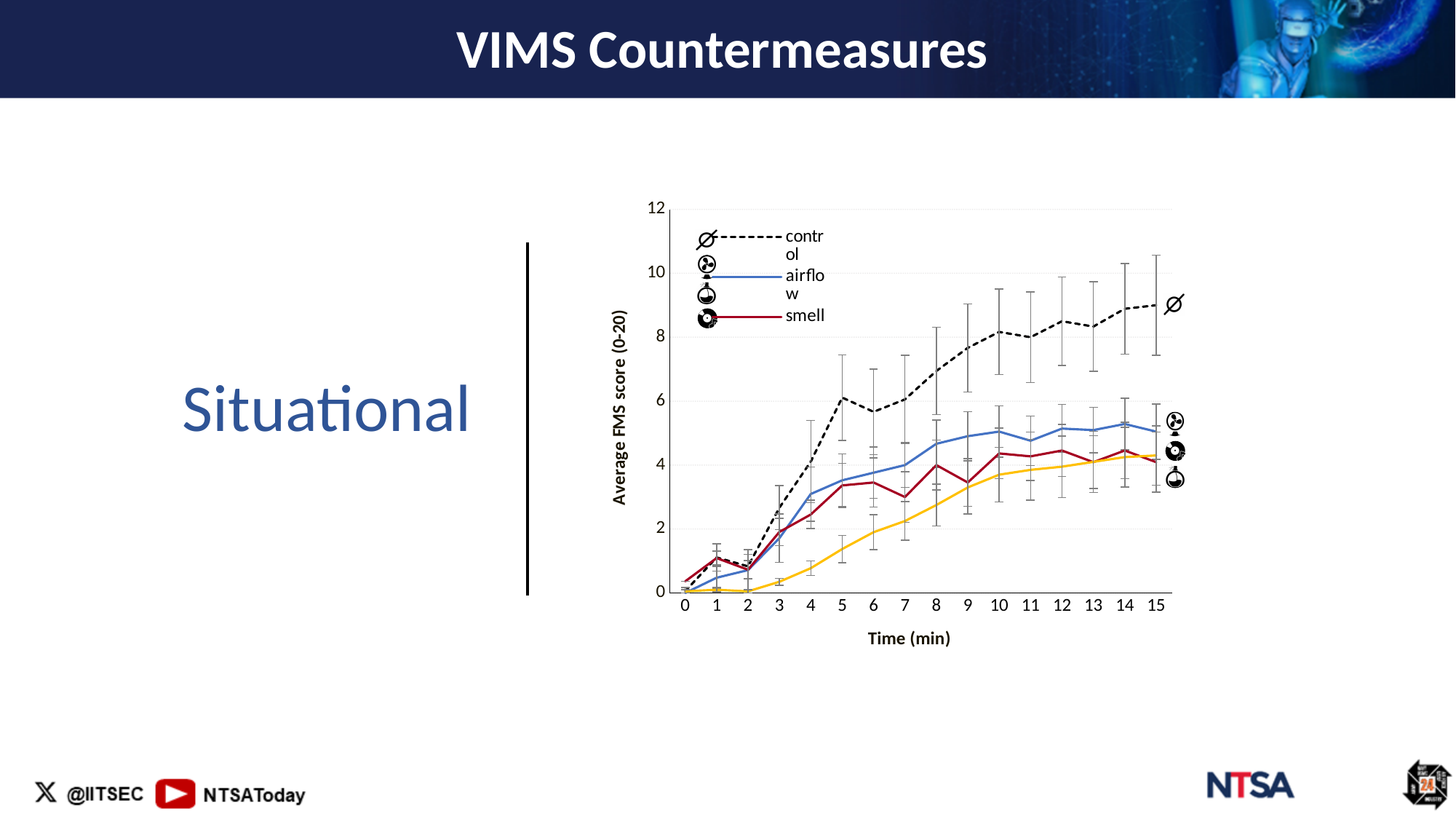
Is the value for airflow at 15 minutes greater or less than 6? less What is the y-axis title of the chart? Average FMS score (0-20) What is the x-axis title of the chart? Time (min) What kind of chart is shown on the slide? line chart Does the control series rise or fall as time increases from 0 to 15 minutes? rise How many time points are marked on the x axis of the chart? 16 Is the value for control at 5 minutes greater or less than 4? greater Which series has the highest value at 15 minutes? control At 15 minutes, which is larger: the control value or the airflow value? control Is the value for control at 15 minutes greater or less than 8? greater How many series does the chart's legend list? 3